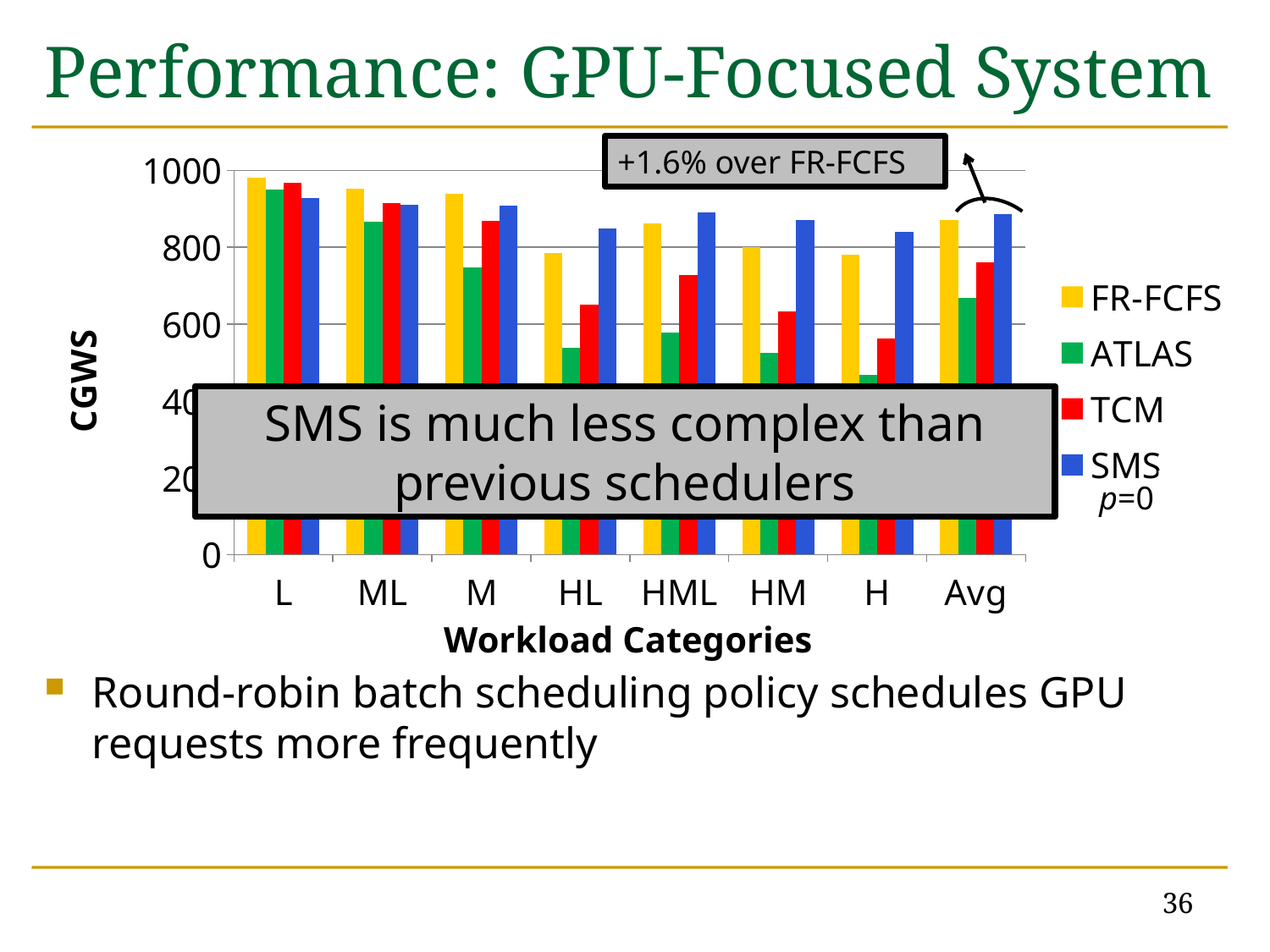
What kind of chart is shown on the slide? bar chart Is the SMS value for HML greater or less than 800? greater How many workload categories are shown on the x axis? 8 Is the ATLAS value for M greater or less than 800? less For the HL category, which is larger, FR-FCFS or ATLAS? FR-FCFS Is the TCM value for HL greater or less than 600? greater What is the label of the x axis? Workload Categories Which series has the lowest value for the HM category? ATLAS How many series does the legend list? 4 What is the label of the y axis? CGWS For the H category, which is larger, SMS or TCM? SMS